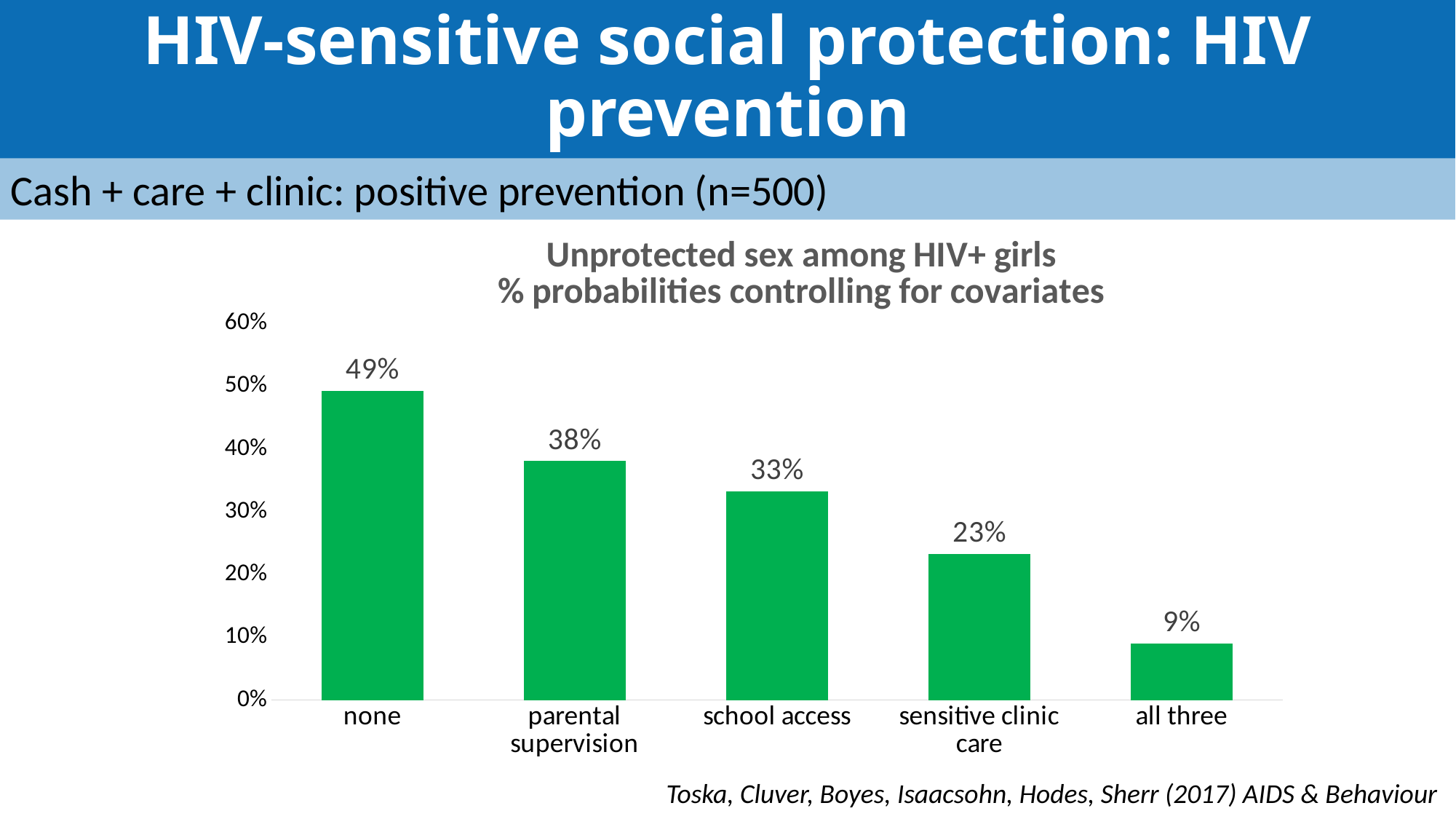
What kind of chart is shown on the slide? bar chart How many categories are shown on the chart? 5 Which category has the lowest value? all three Which category has the highest value? none What is the value for 'none'? 49% Which is larger, the value for 'parental supervision' or the value for 'school access'? parental supervision What is the value for 'sensitive clinic care'? 23% What is the value for 'all three'? 9% Do the values rise or fall from left to right along the x axis? fall What is the value for 'school access'? 33% What is the value for 'parental supervision'? 38% What is the difference between the values for 'none' and 'all three'? 40%